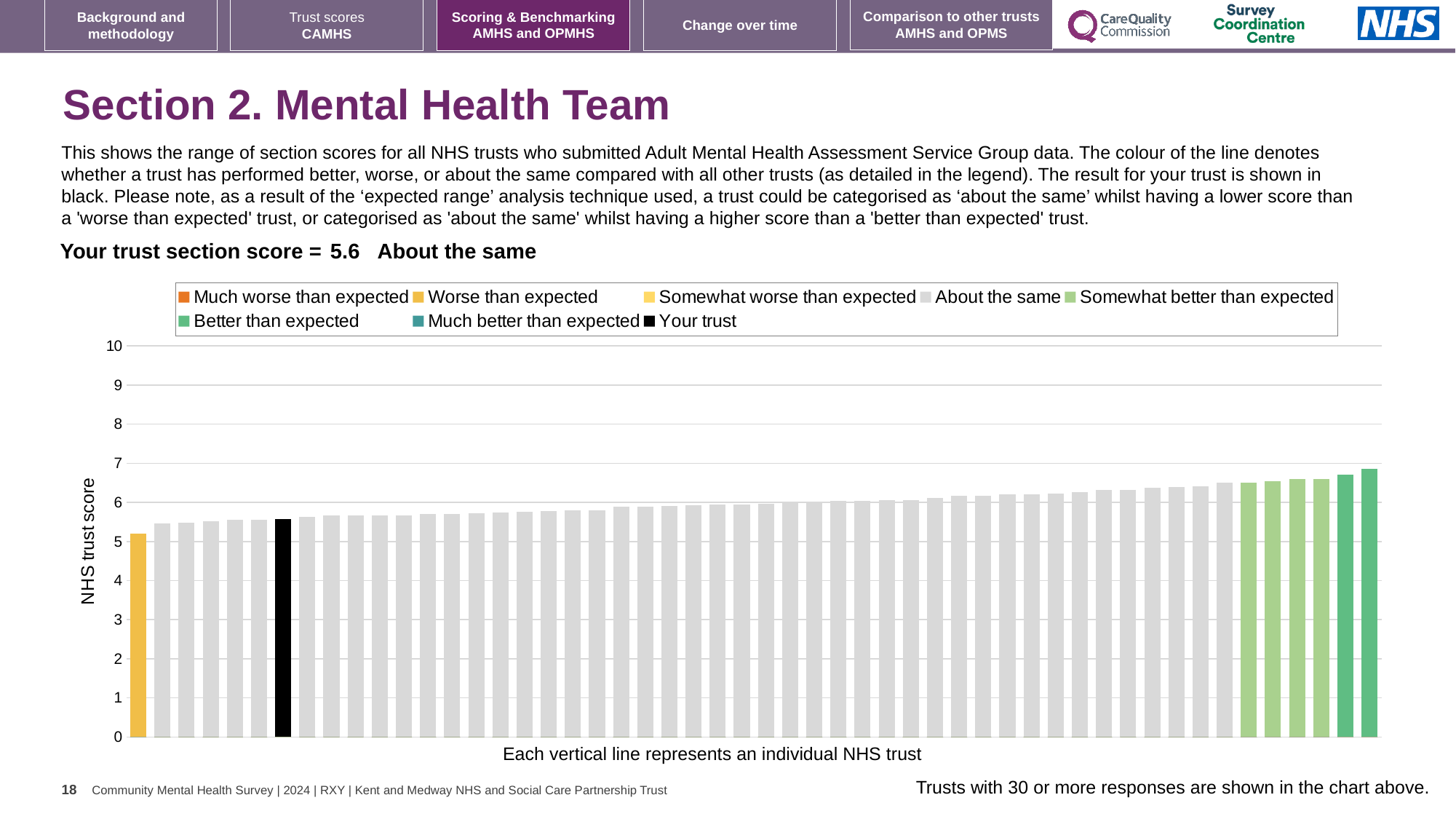
How many bars are coloured as 'Much better than expected'? 0 What is the section score for your trust? 5.6 Is the value for the leftmost bar greater or less than 6? less Is the value for your trust greater or less than 6? less Is the value for the tallest bar greater or less than 7? less Which is larger: the bar for your trust or the leftmost (Worse than expected) bar? Your trust How many entries does the chart legend list? 8 What kind of chart is shown on the slide? bar chart Do the bar values rise or fall from left to right along the x axis? rise What is the label on the vertical axis of the chart? NHS trust score What colour is the bar representing your trust? black Which category is your trust placed in for this section? About the same